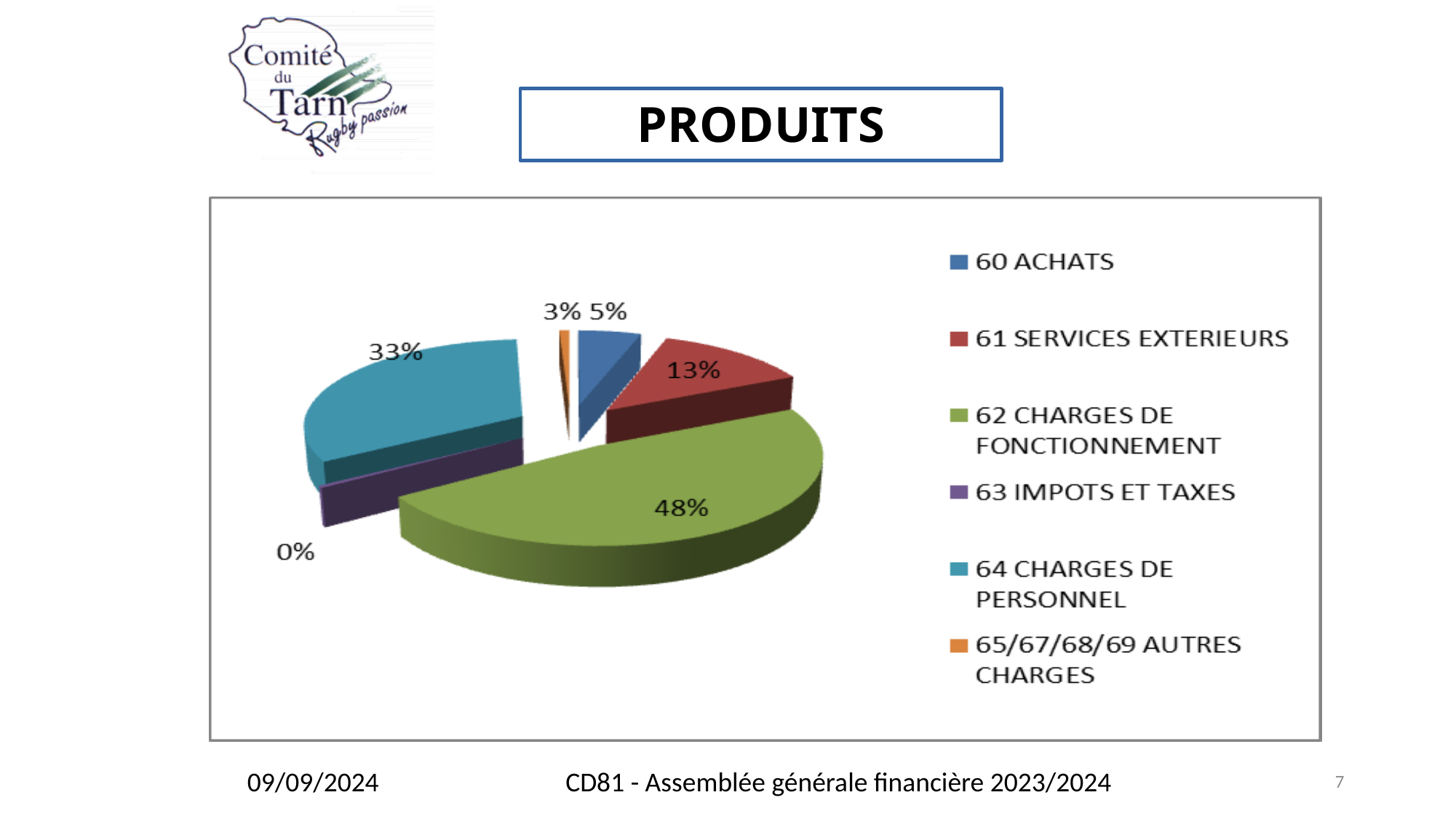
What share of the pie does 65/67/68/69 AUTRES CHARGES represent? 3% Which is larger, the share for 61 SERVICES EXTERIEURS or the share for 60 ACHATS? 61 SERVICES EXTERIEURS How many categories does the legend list? 6 What share of the pie does 61 SERVICES EXTERIEURS represent? 13% What share of the pie does 64 CHARGES DE PERSONNEL represent? 33% Which category has the smallest slice of the pie? 63 IMPOTS ET TAXES What is the difference in percentage points between 62 CHARGES DE FONCTIONNEMENT and 64 CHARGES DE PERSONNEL? 15 What kind of chart is shown on the slide? pie chart Which category has the largest slice of the pie? 62 CHARGES DE FONCTIONNEMENT